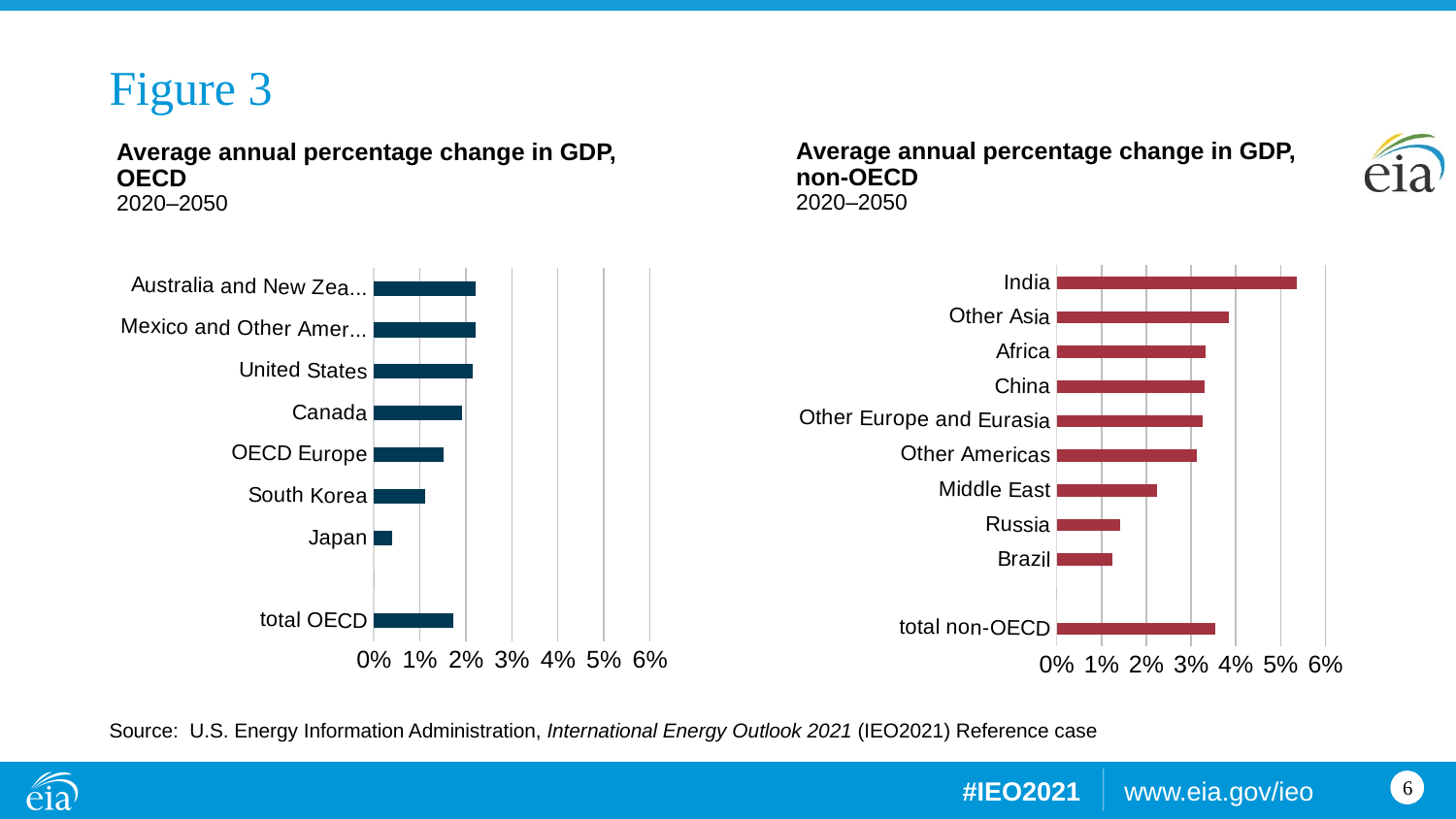
In the 'Average annual percentage change in GDP, non-OECD' chart, is the value for India greater or less than 4%? greater In the 'Average annual percentage change in GDP, OECD' chart, which category has the lowest value? Japan What kind of chart is the 'Average annual percentage change in GDP, OECD' chart? bar chart In the 'Average annual percentage change in GDP, non-OECD' chart, is the value for Russia greater or less than 2%? less How many bars are shown in the 'Average annual percentage change in GDP, OECD' chart? 8 In the 'Average annual percentage change in GDP, OECD' chart, is the value for Japan greater or less than 1%? less In the 'Average annual percentage change in GDP, non-OECD' chart, which is larger, the value for Other Asia or the value for Brazil? Other Asia In the 'Average annual percentage change in GDP, non-OECD' chart, which category has the highest value? India How many bars are shown in the 'Average annual percentage change in GDP, non-OECD' chart? 10 What time period is shown in the subtitle of the 'Average annual percentage change in GDP, OECD' chart? 2020–2050